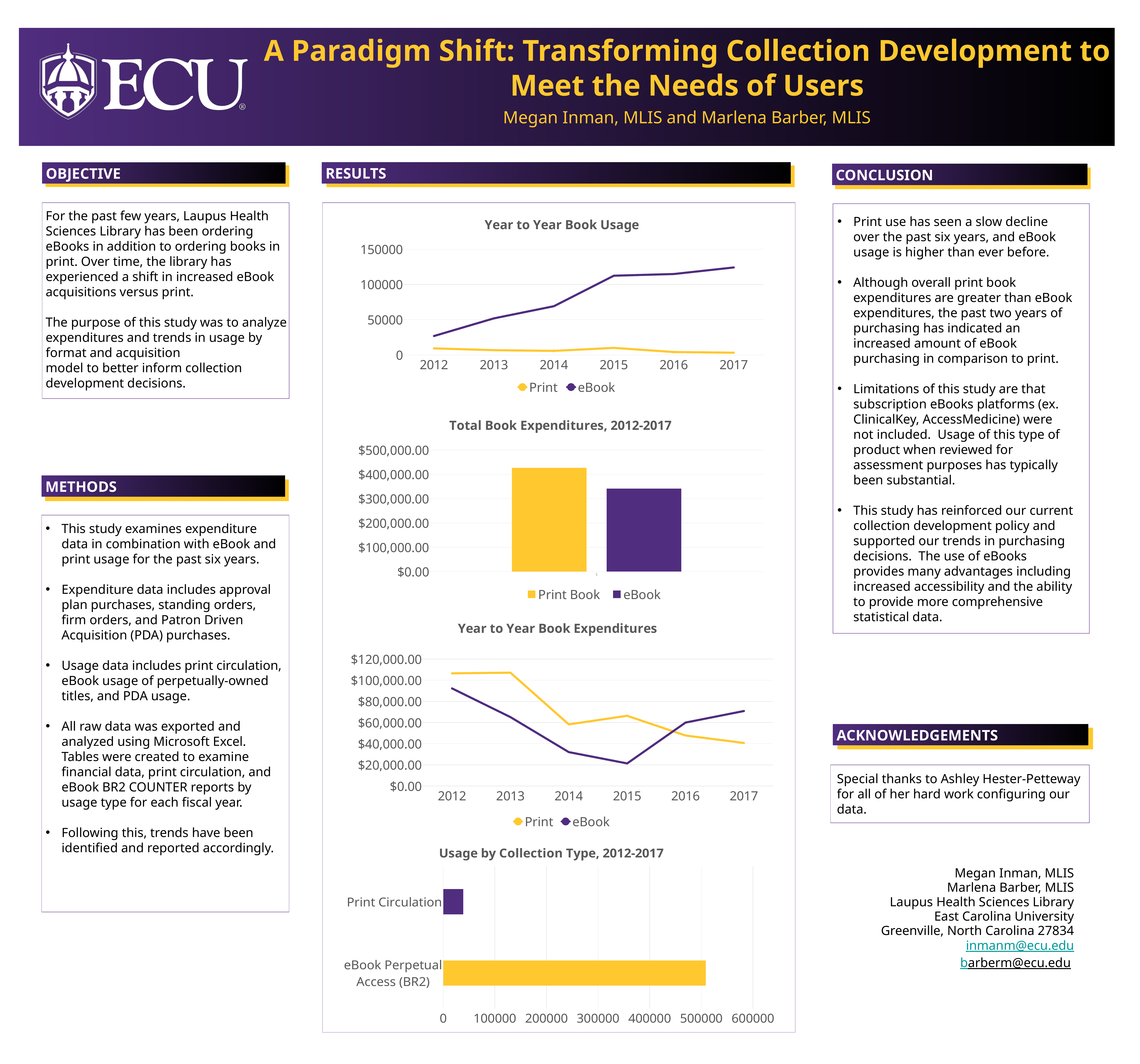
What type of chart is "Year to Year Book Usage"? line chart In the "Year to Year Book Usage" chart, is the eBook value for 2017 greater or less than 100000? greater In the "Total Book Expenditures, 2012-2017" chart, is the value for Print Book greater or less than $400,000.00? greater In the "Year to Year Book Usage" chart, does eBook usage rise or fall from 2012 to 2017? rise In the "Year to Year Book Usage" chart, how many series does the legend list? 2 In the "Year to Year Book Expenditures" chart, which year has the lowest eBook expenditure? 2015 What type of chart is "Total Book Expenditures, 2012-2017"? bar chart In the "Usage by Collection Type, 2012-2017" chart, which category has the highest usage? eBook Perpetual Access (BR2) In the "Year to Year Book Expenditures" chart, is the Print value for 2012 greater or less than $100,000.00? greater In the "Year to Year Book Usage" chart, how many years are shown on the x axis? 6 In the "Total Book Expenditures, 2012-2017" chart, which category has the higher expenditure, Print Book or eBook? Print Book In the "Year to Year Book Expenditures" chart, which series has the higher value in 2017, Print or eBook? eBook